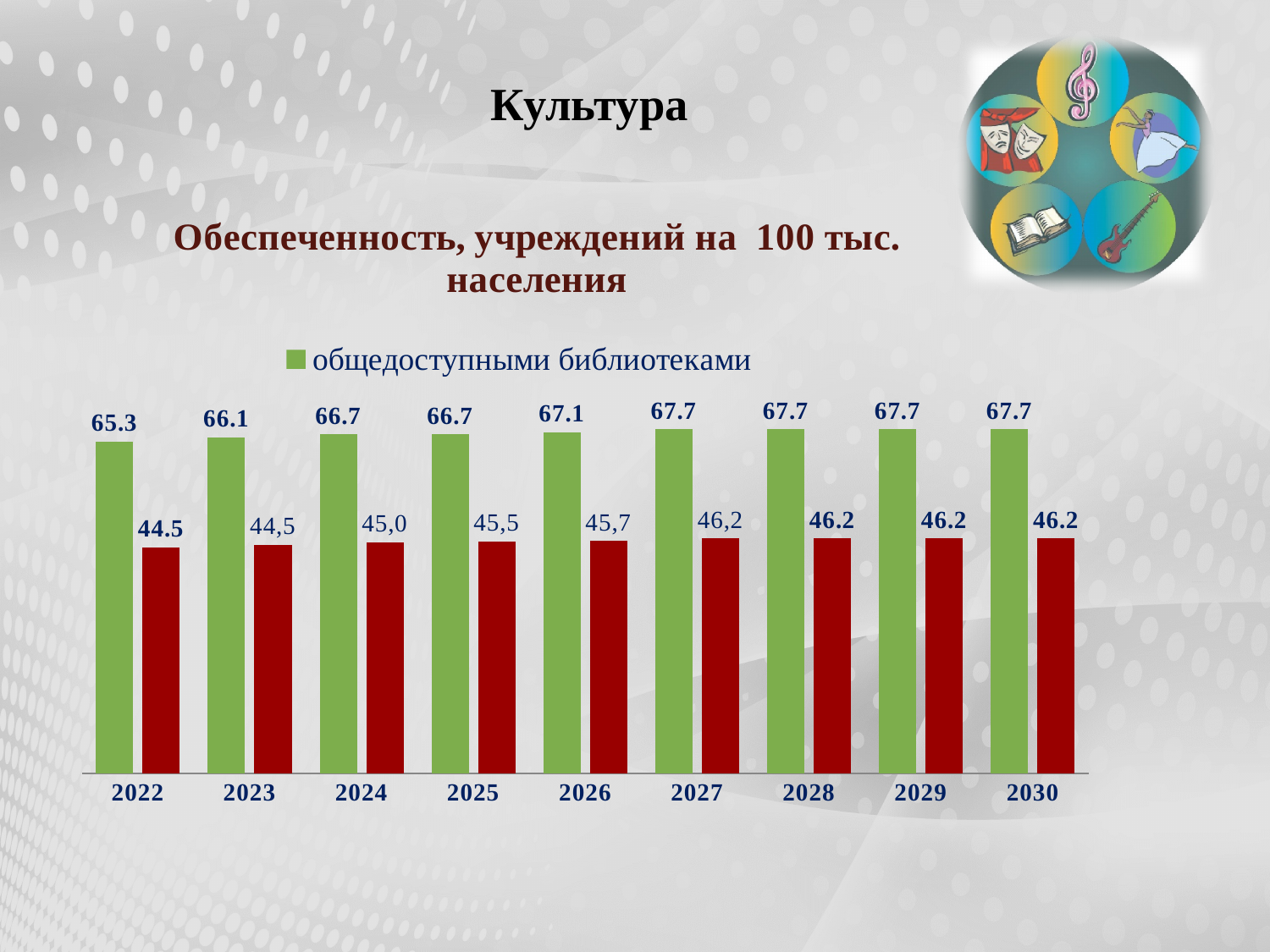
Do the values for общедоступными библиотеками rise or fall from 2022 to 2027? rise What is the value of the red bar for 2030? 46.2 How many years are shown on the x axis? 9 In which year is the value for общедоступными библиотеками the lowest? 2022 What is the difference between the общедоступными библиотеками value in 2023 and in 2022? 0.8 What type of chart is shown on the slide? bar chart What is the value for общедоступными библиотеками in 2026? 67.1 Which is larger in 2025: the green bar or the red bar? the green bar What is the value of the red bar for 2024? 45,0 What is the difference between the green bar and the red bar in 2022? 20.8 How many series does the legend list? 1 What is the value for общедоступными библиотеками in 2022? 65.3